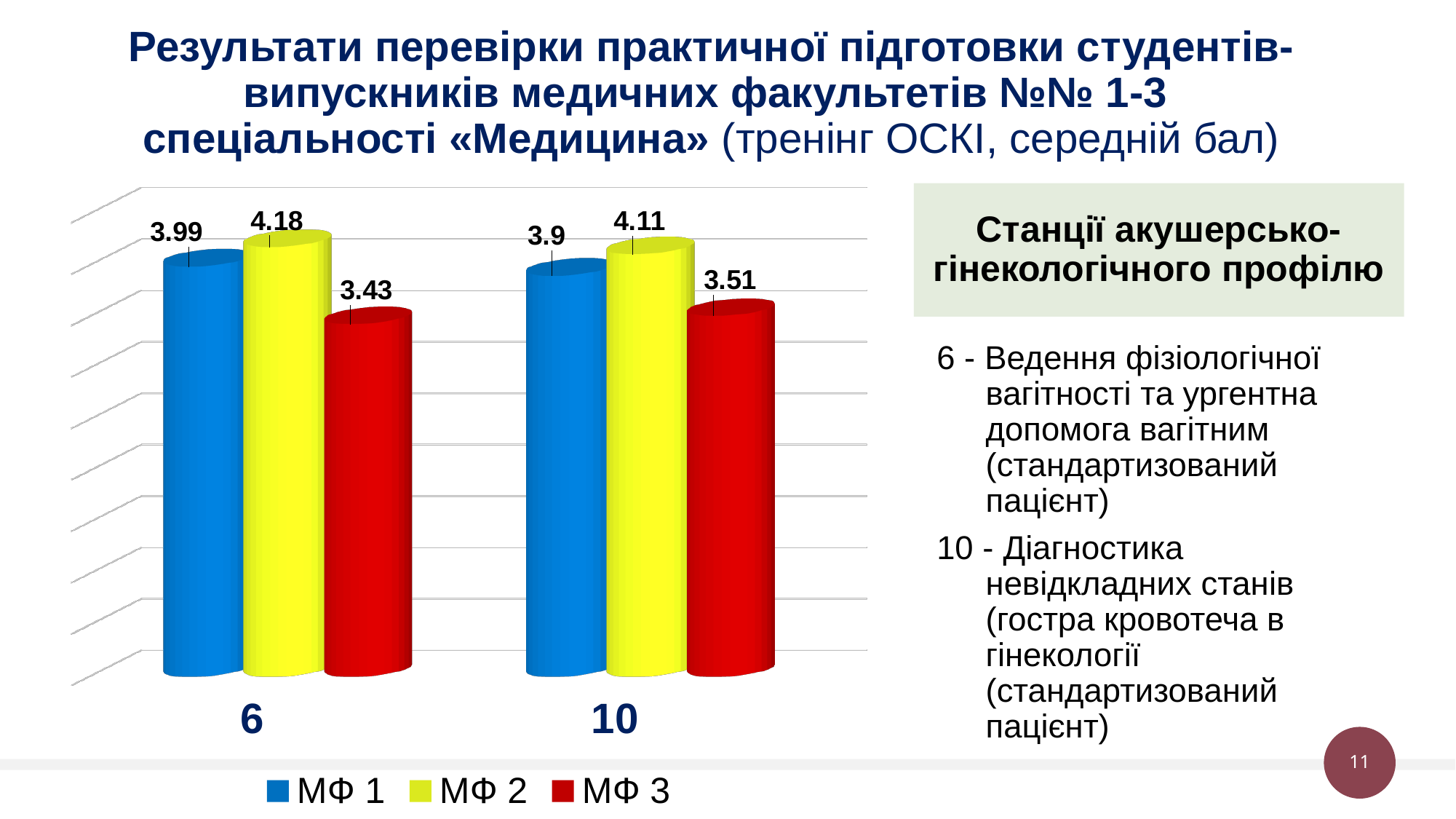
How many series does the legend list? 3 What is the difference between the МФ 2 and МФ 3 values at station 6? 0.75 What is the value for МФ 3 at station 6? 3.43 Which is larger: the МФ 3 value at station 6 or the МФ 3 value at station 10? station 10 What is the value for МФ 1 at station 10? 3.9 What is the value for МФ 2 at station 10? 4.11 What is the difference between the МФ 1 and МФ 3 values at station 10? 0.39 Which series has the highest value at station 6? МФ 2 What kind of chart is shown on the slide? bar chart What is the value for МФ 1 at station 6? 3.99 How many categories are shown on the x axis of the chart? 2 Which series has the lowest value at station 10? МФ 3